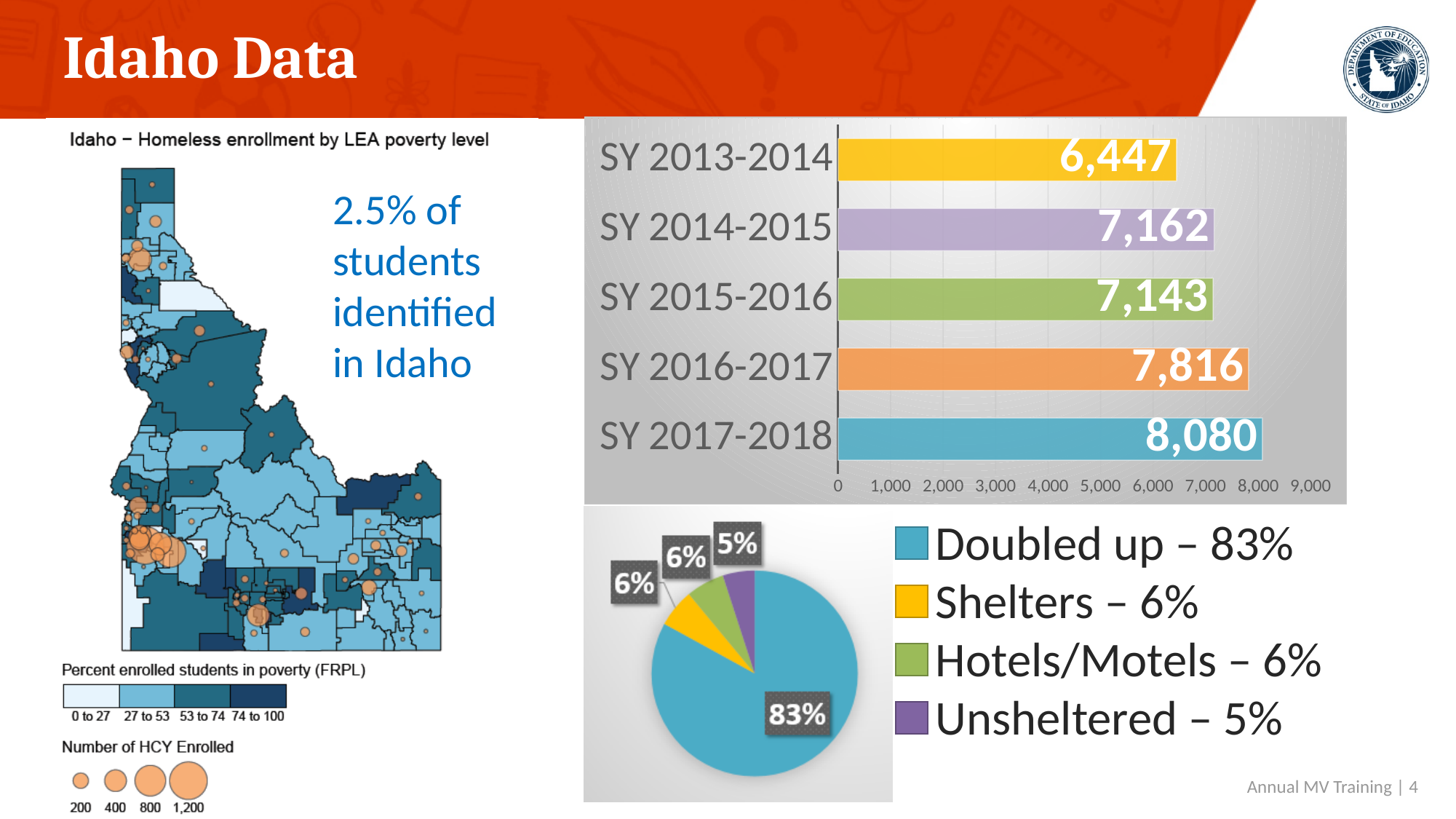
In the pie chart at the bottom right, how many categories does the legend list? 4 In the bar chart at the top right, what is the difference between SY 2017-2018 and SY 2016-2017? 264 In the bar chart at the top right, what is the value for SY 2013-2014? 6,447 What kind of chart is shown at the top right of the slide? Bar chart In the bar chart at the top right, how many school years are shown? 5 In the bar chart at the top right, what is the value for SY 2017-2018? 8,080 In the bar chart at the top right, which school year has the highest value? SY 2017-2018 In the bar chart at the top right, do the values generally rise or fall from SY 2013-2014 to SY 2017-2018? Rise In the bar chart at the top right, which is larger, SY 2014-2015 or SY 2015-2016? SY 2014-2015 In the pie chart at the bottom right, what share is Unsheltered? 5% In the pie chart at the bottom right, what share is Doubled up? 83% In the bar chart at the top right, which school year has the lowest value? SY 2013-2014